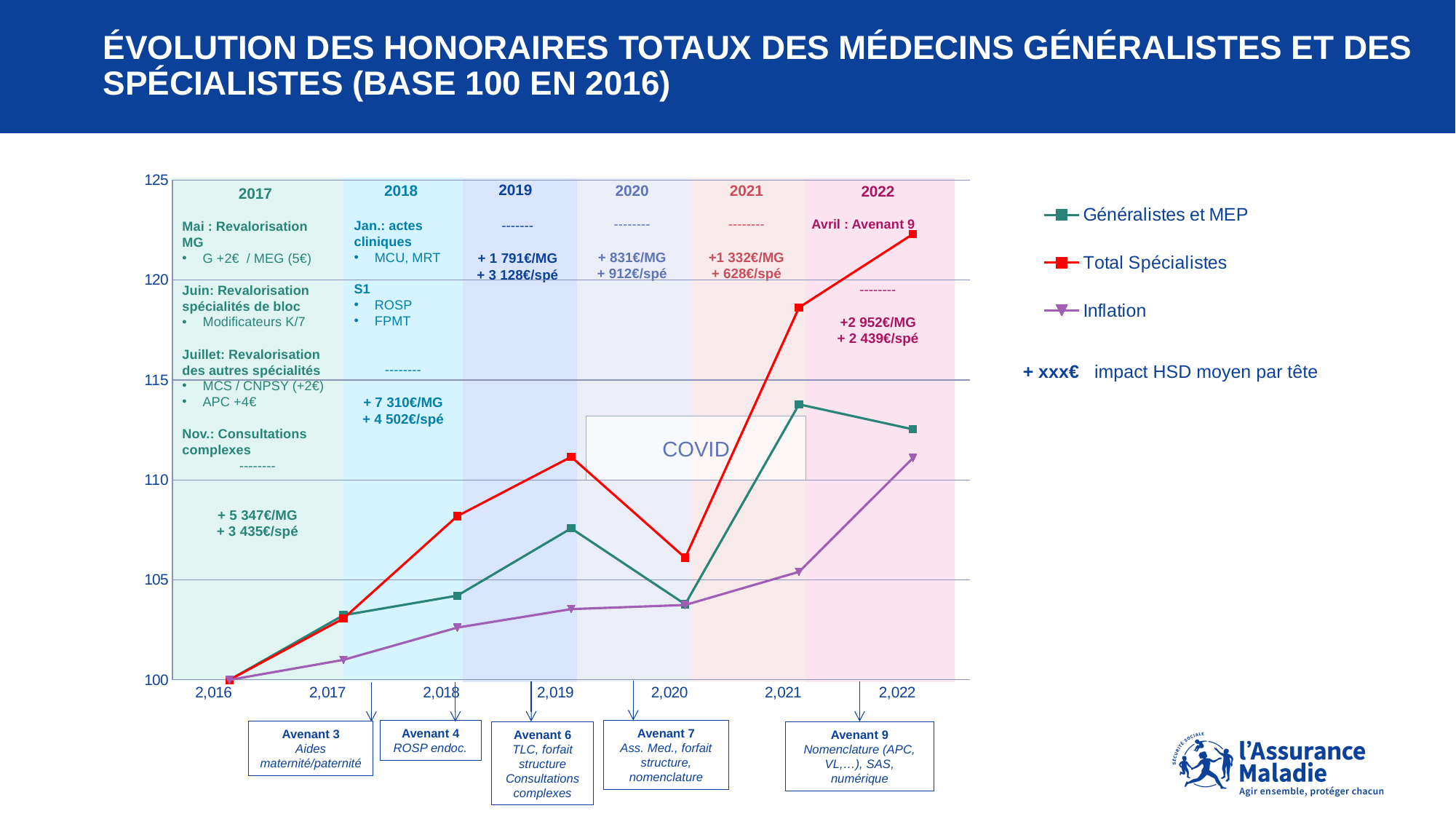
What kind of chart is shown on the slide? line chart Is the value for Inflation in 2021 greater or less than 110? less Which series has the higher value in 2021, Total Spécialistes or Généralistes et MEP? Total Spécialistes How many years are plotted along the x axis? 7 What is the value of all three series in 2016? 100 Is the value for Généralistes et MEP in 2019 greater or less than 105? greater Does the Inflation series rise or fall from 2016 to 2022? rise Is the value for Total Spécialistes in 2022 greater or less than 120? greater In which year does the Total Spécialistes series reach its highest value? 2022 Which series is drawn in red in the legend? Total Spécialistes How many series does the legend list? 3 In which year does the Généralistes et MEP series reach its highest value? 2021